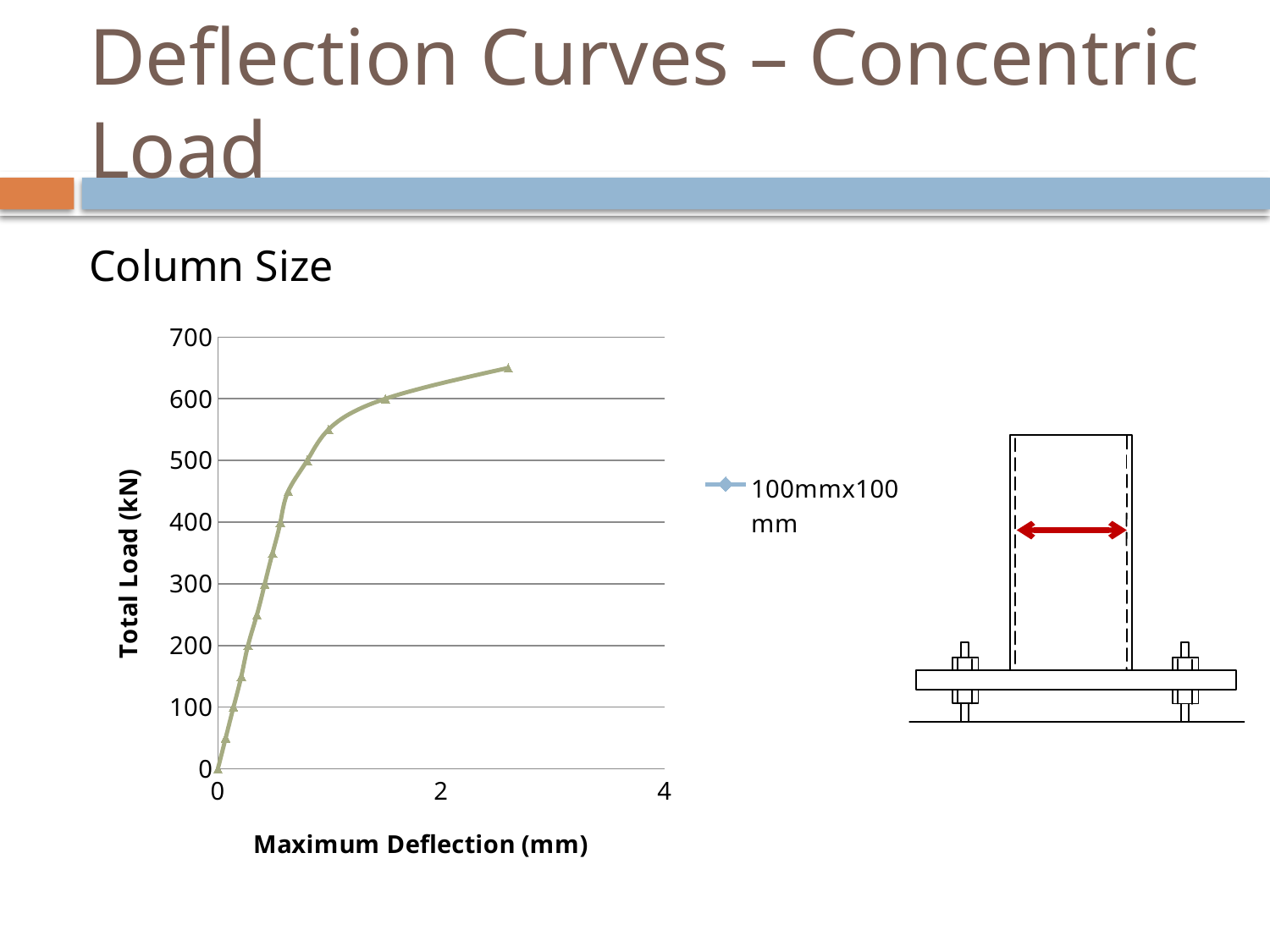
Is the maximum deflection at a total load of 300 kN greater or less than 2? less What is the title of the vertical axis of the chart? Total Load (kN) What kind of chart is shown on the slide? line chart Is the highest total load reached by the curve greater or less than 600? greater Is the maximum deflection at a total load of 600 kN greater or less than 2? less How many series does the chart legend list? 1 Does the total load rise or fall as the maximum deflection increases along the x axis? rises What is the name of the series shown in the chart legend? 100mmx100 mm